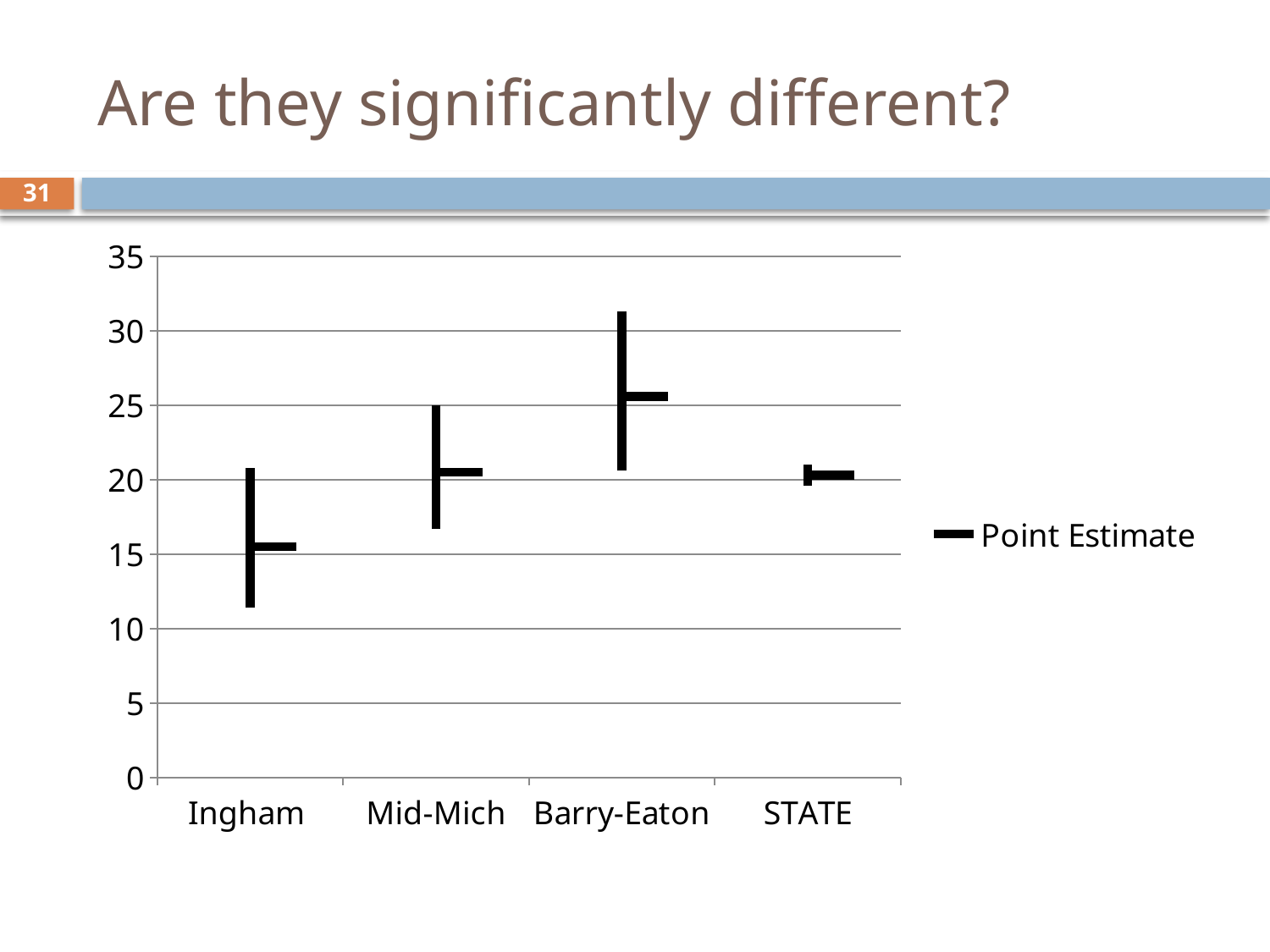
Is the point estimate for STATE greater or less than 25? less Which category has the highest point estimate? Barry-Eaton How many series does the legend list? 1 Is the point estimate for Mid-Mich greater or less than 15? greater Which has the larger point estimate, Ingham or Mid-Mich? Mid-Mich Is the point estimate for Ingham greater or less than 20? less Which category has the lowest point estimate? Ingham Which has the larger point estimate, Barry-Eaton or STATE? Barry-Eaton What is the name of the series shown in the legend? Point Estimate How many categories are shown on the x axis? 4